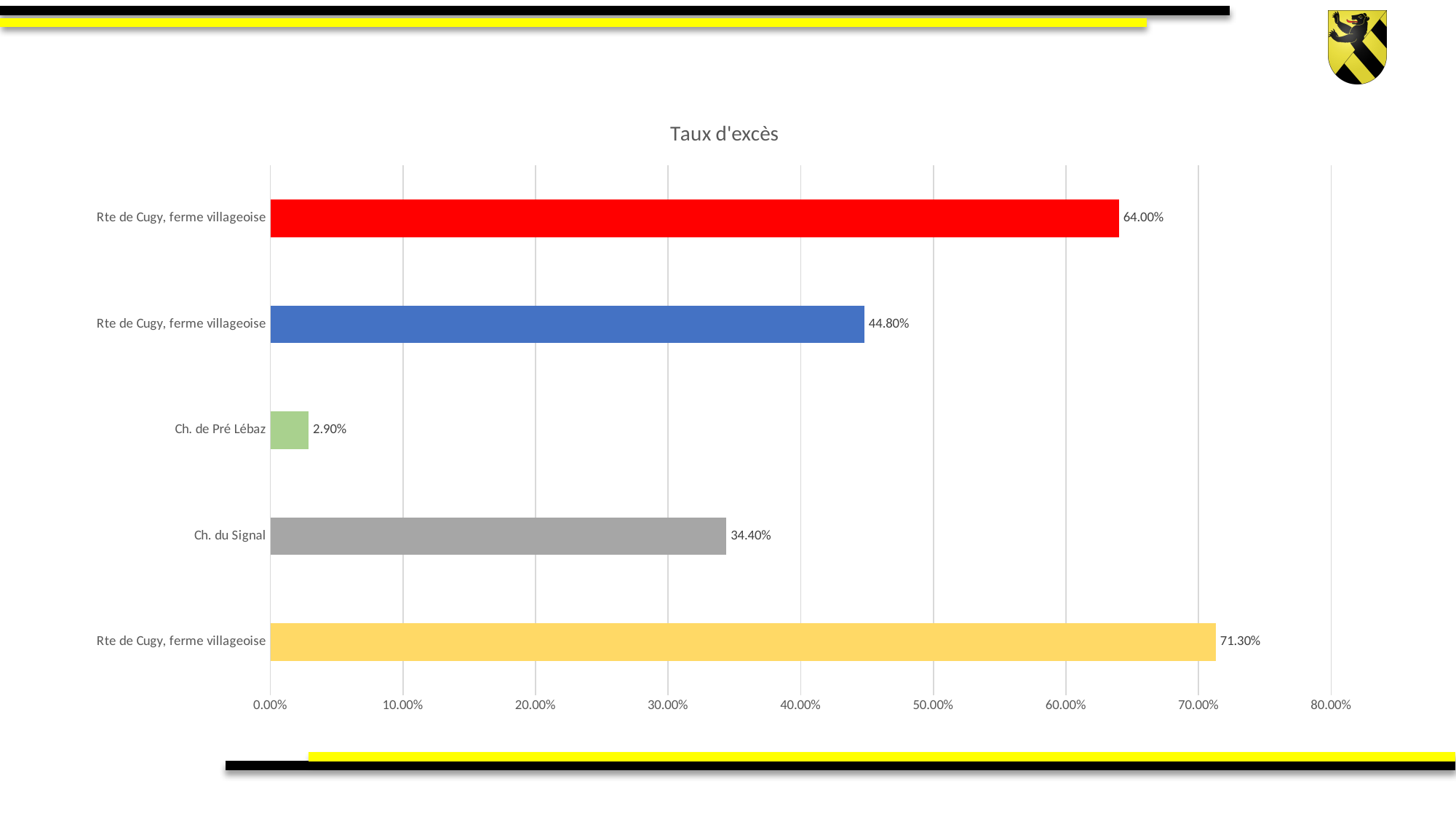
How many bars are plotted in the chart? 5 What is the value for Ch. de Pré Lébaz? 2.90% Which is larger, the value of the blue bar or the value of Ch. du Signal? the blue bar (44.80%) Which bar has the highest value? the bottom Rte de Cugy, ferme villageoise bar (yellow), 71.30% What type of chart is shown on the slide? bar chart What is the title of the chart? Taux d'excès What is the value of the blue bar? 44.80% Which category has the lowest value? Ch. de Pré Lébaz What is the value for Ch. du Signal? 34.40% What is the difference between the value of Ch. du Signal and the value of Ch. de Pré Lébaz? 31.50% What is the value of the red bar (top 'Rte de Cugy, ferme villageoise')? 64.00% What is the value of the yellow bar at the bottom of the chart? 71.30%